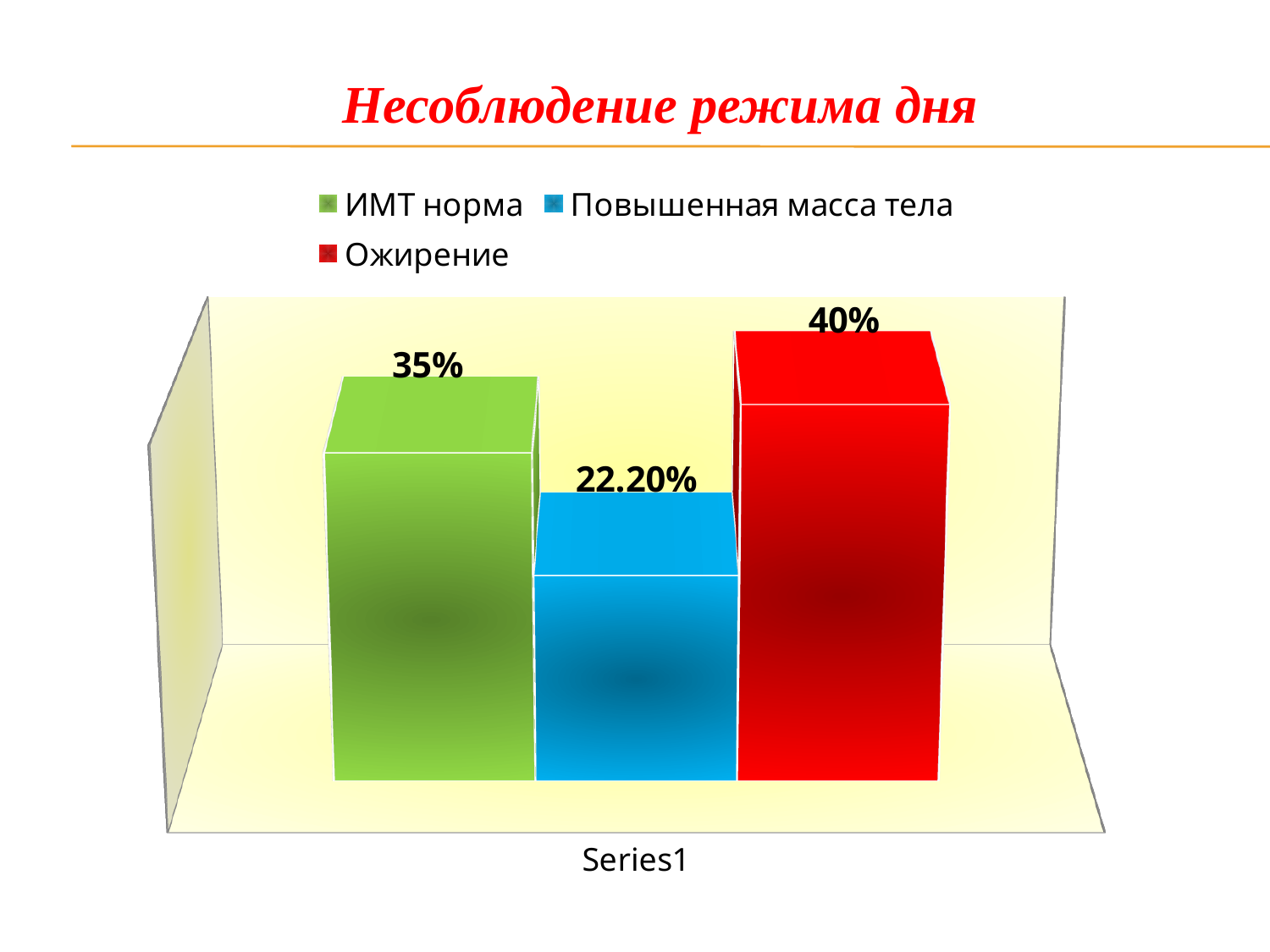
What kind of chart is shown on the slide? Bar chart Which series has the highest value? Ожирение What is the value for Повышенная масса тела? 22.20% Which is larger, the value for ИМТ норма or the value for Повышенная масса тела? ИМТ норма What is the value for ИМТ норма? 35% What is the category label shown under the bars? Series1 What is the value for Ожирение? 40% How many series does the legend list? 3 What colour is the bar for Ожирение? Red What is the title of the slide? Несоблюдение режима дня Which series has the lowest value? Повышенная масса тела What is the difference between the values for Ожирение and ИМТ норма? 5%